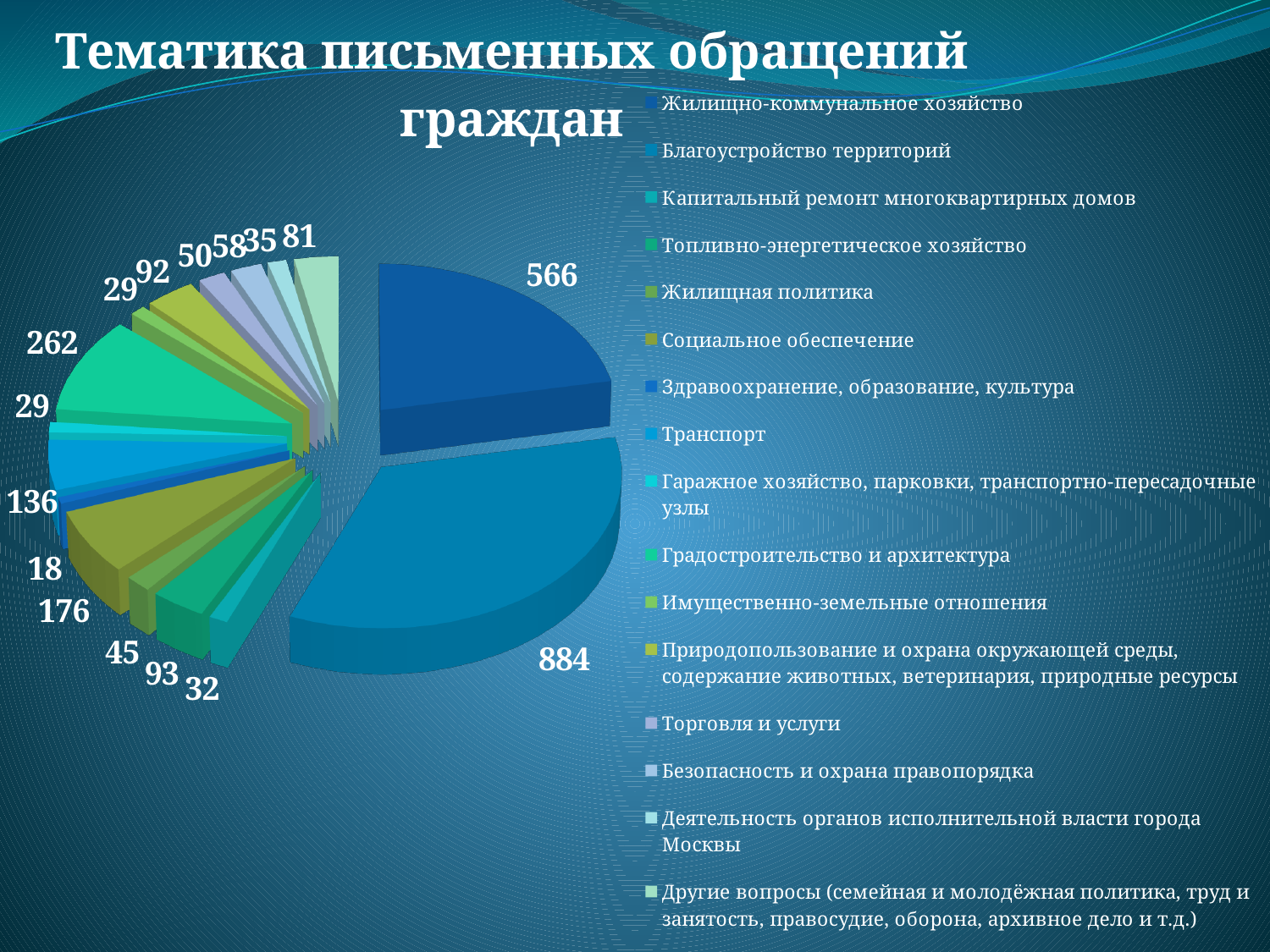
How many categories does the legend list? 16 Which category has the smallest slice? Здравоохранение, образование, культура What is the value for Жилищно-коммунальное хозяйство? 566 What is the value for Транспорт? 136 What is the value for Градостроительство и архитектура? 262 What is the value for Социальное обеспечение? 176 Which is larger, the value for Жилищно-коммунальное хозяйство or the value for Градостроительство и архитектура? Жилищно-коммунальное хозяйство Which category has the largest slice? Благоустройство территорий What is the value for Благоустройство территорий? 884 What type of chart is shown on the slide? pie chart What is the difference between the values for Благоустройство территорий and Жилищно-коммунальное хозяйство? 318 What is the title of the chart? Тематика письменных обращений граждан